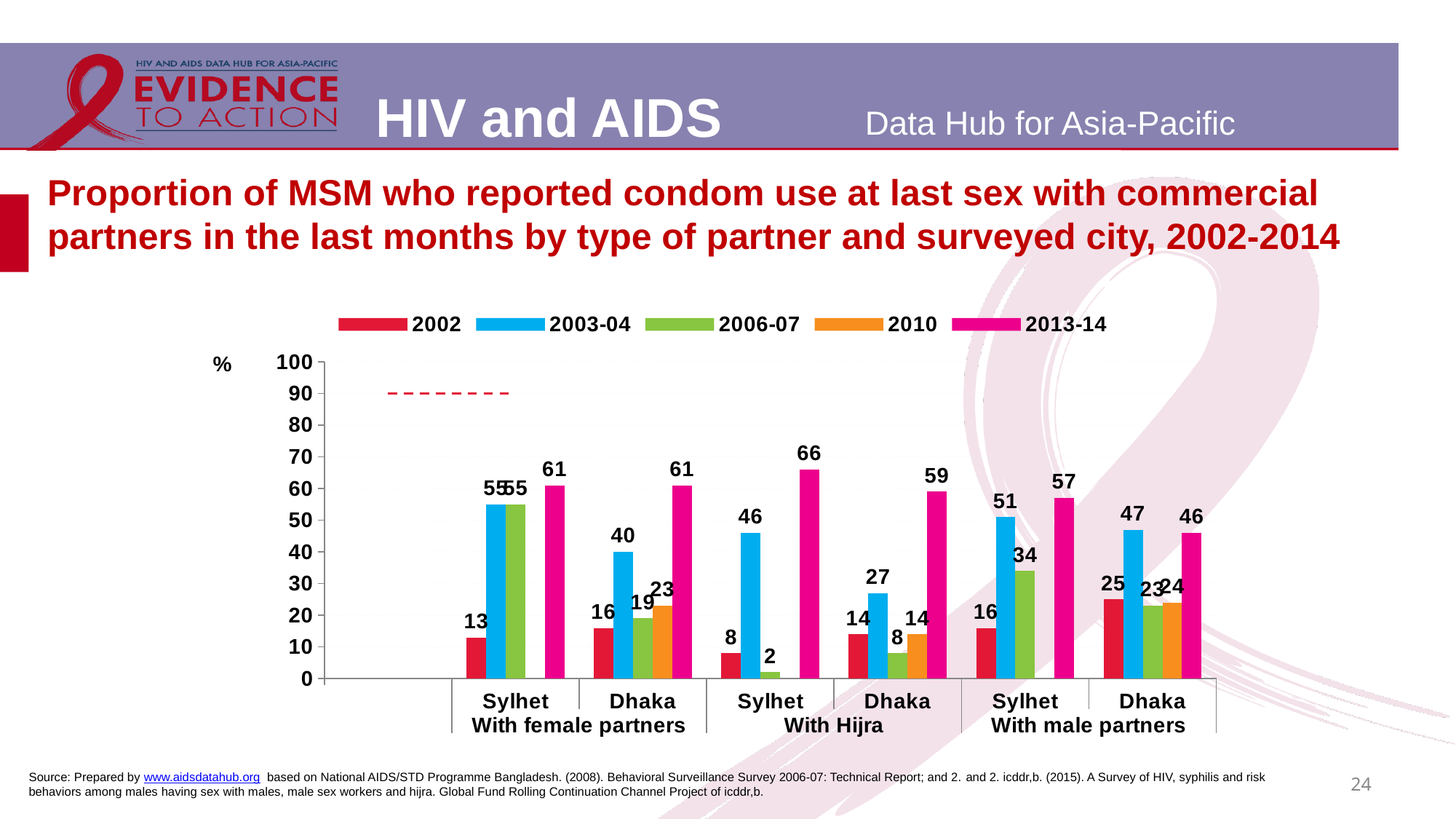
How many city/partner-type categories are shown on the x axis? 6 Which is larger for Sylhet with male partners: the 2003-04 value or the 2006-07 value? 2003-04 Which city and partner type has the lowest 2002 value? Sylhet, with Hijra Which city and partner type has the highest 2013-14 value? Sylhet, with Hijra Which colour represents the 2010 series in the legend? Orange What kind of chart is shown on the slide? Bar chart What is the 2006-07 value for Sylhet with Hijra? 2 What is the 2013-14 value for Sylhet with Hijra? 66 How many series does the legend list? 5 What is the difference between the 2013-14 and 2002 values for Dhaka with Hijra? 45 What is the 2002 value for Dhaka with male partners? 25 What is the 2003-04 value for Dhaka with female partners? 40